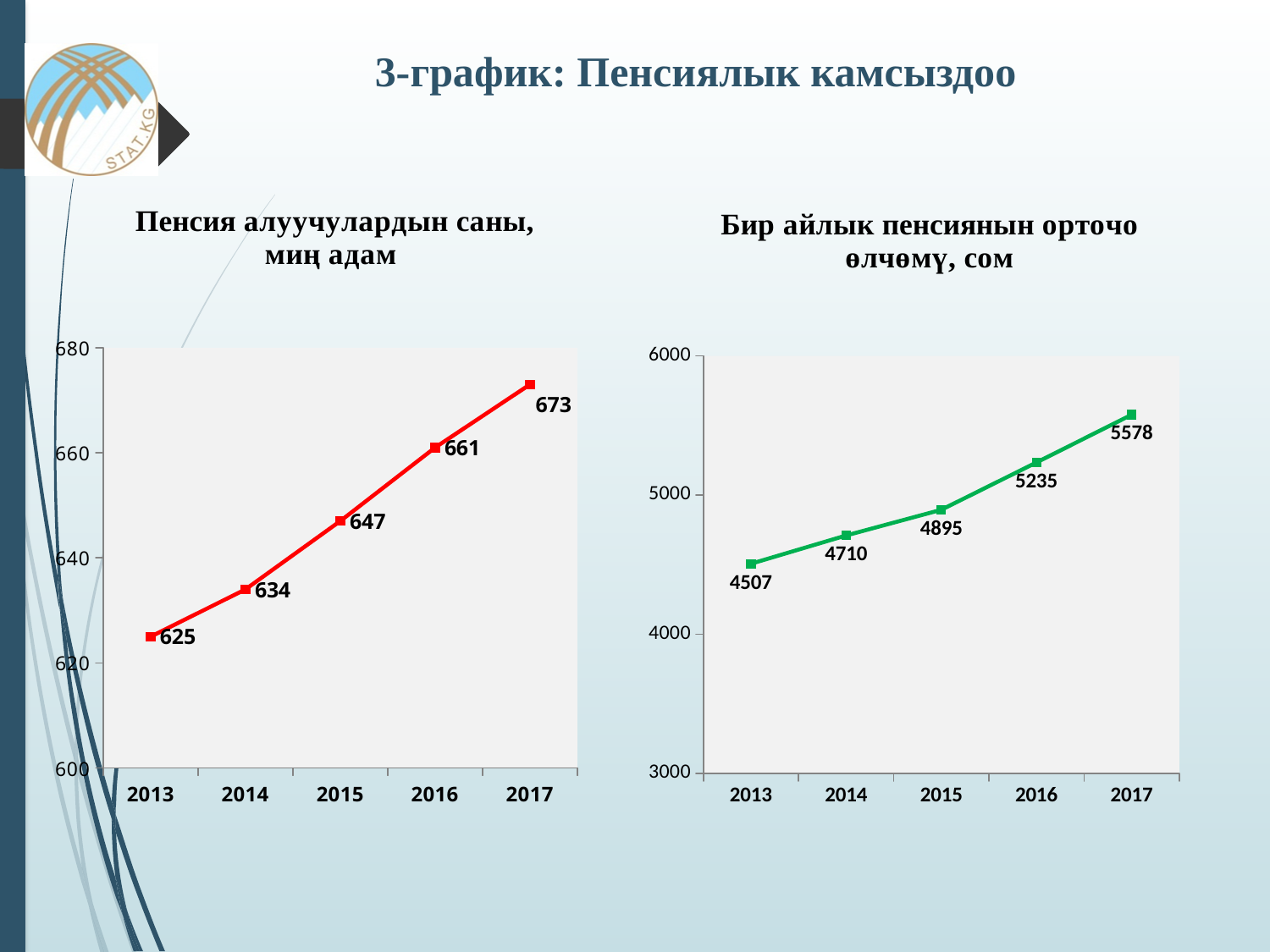
In the right chart (Бир айлык пенсиянын орточо өлчөмү, сом), what is the value for 2014? 4710 In the right chart (Бир айлык пенсиянын орточо өлчөмү, сом), is the value for 2016 greater or less than 5000? greater In the right chart (Бир айлык пенсиянын орточо өлчөмү, сом), which is larger, the value for 2015 or the value for 2014? 2015 How many years are plotted in the left chart (Пенсия алуучулардын саны, миң адам)? 5 In the left chart (Пенсия алуучулардын саны, миң адам), do the values rise or fall from 2013 to 2017? rise In the left chart (Пенсия алуучулардын саны, миң адам), what is the value for 2015? 647 What colour is the line in the left chart (Пенсия алуучулардын саны, миң адам)? red In the right chart (Бир айлык пенсиянын орточо өлчөмү, сом), which year has the lowest value? 2013 What kind of chart is the right chart (Бир айлык пенсиянын орточо өлчөмү, сом)? line chart In the left chart (Пенсия алуучулардын саны, миң адам), what is the difference between the values for 2017 and 2013? 48 In the right chart (Бир айлык пенсиянын орточо өлчөмү, сом), what is the difference between the values for 2016 and 2015? 340 In the left chart (Пенсия алуучулардын саны, миң адам), which year has the highest value? 2017